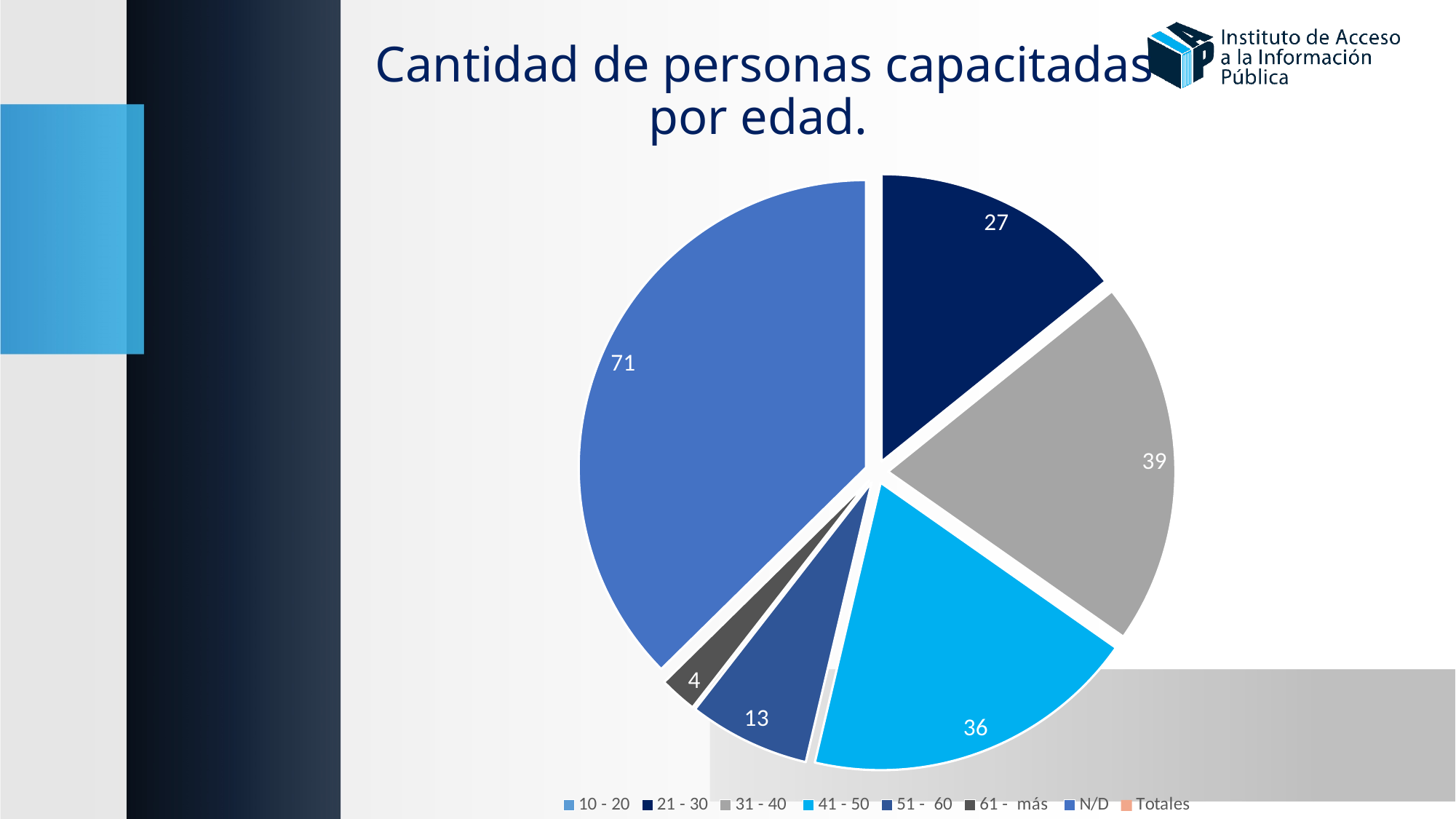
What is the value for the 31 - 40 age group? 39 What is the title of the chart? Cantidad de personas capacitadas por edad. What is the value for the 51 - 60 age group? 13 What is the value for the N/D slice? 71 What is the difference between the N/D value and the 31 - 40 value? 32 Which is larger, the value for 21 - 30 or the value for 51 - 60? 21 - 30 What is the value for the 21 - 30 age group? 27 Which category has the largest slice of the pie? N/D Among the labeled slices, which category has the smallest value? 61 - más What is the value for the 61 - más age group? 4 What is the value for the 41 - 50 age group? 36 What type of chart is shown on the slide? pie chart